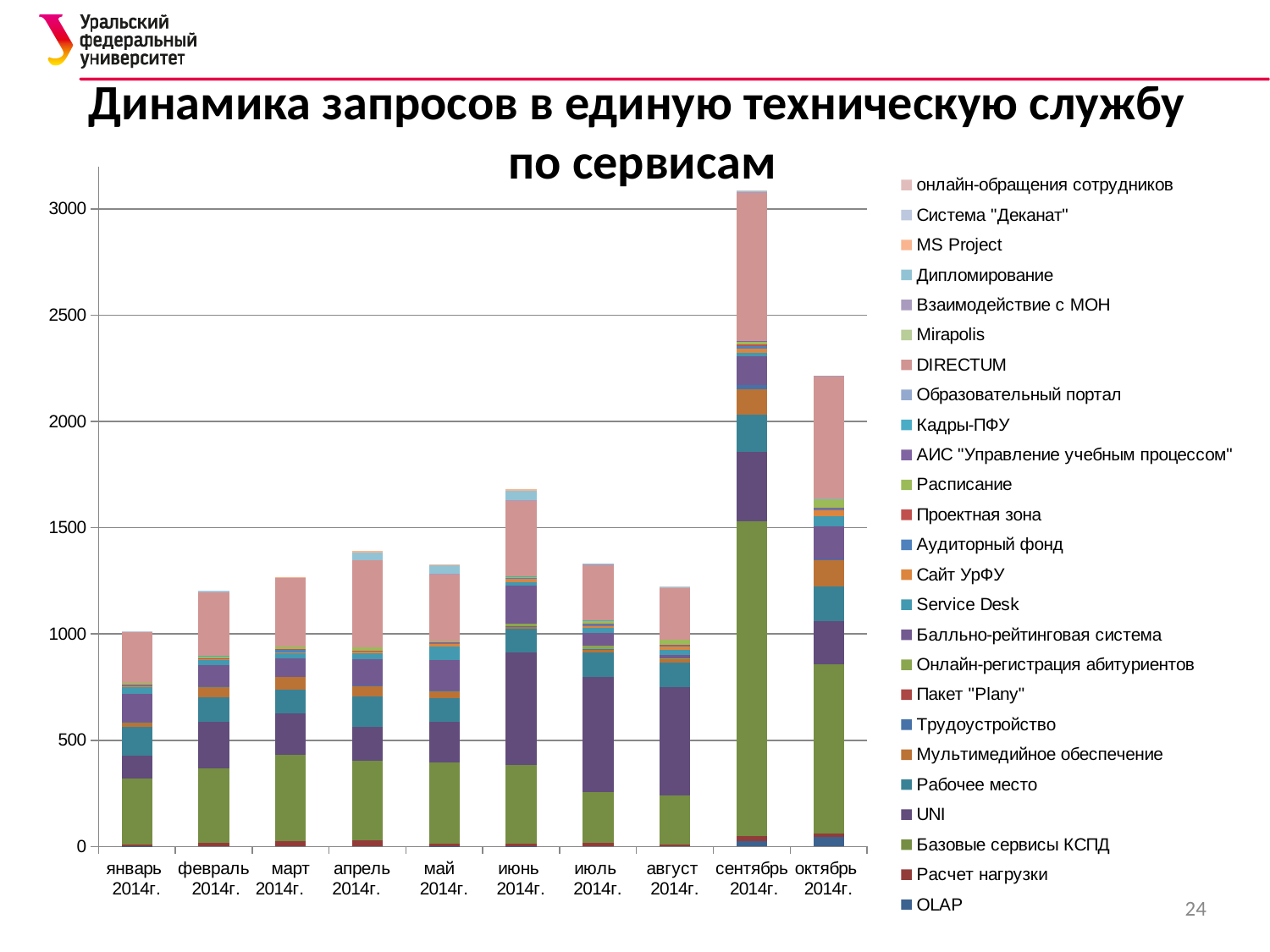
What kind of chart is shown on the slide? stacked bar chart Which month has the tallest stacked bar in the chart? сентябрь 2014г. What is the title of the chart on the slide? Динамика запросов в единую техническую службу по сервисам How many series does the chart's legend list? 25 Is the total bar height for сентябрь 2014г. greater or less than 2500? greater Does the total bar height rise or fall from август 2014г. to сентябрь 2014г.? rise Is the total bar height for январь 2014г. greater or less than 1500? less How many months (categories) are shown on the x axis of the chart? 10 Is the total bar height for октябрь 2014г. greater or less than 2000? greater Which month has the shortest stacked bar in the chart? январь 2014г. Which bar is taller: июнь 2014г. or июль 2014г.? июнь 2014г. Which bar is taller: сентябрь 2014г. or октябрь 2014г.? сентябрь 2014г.